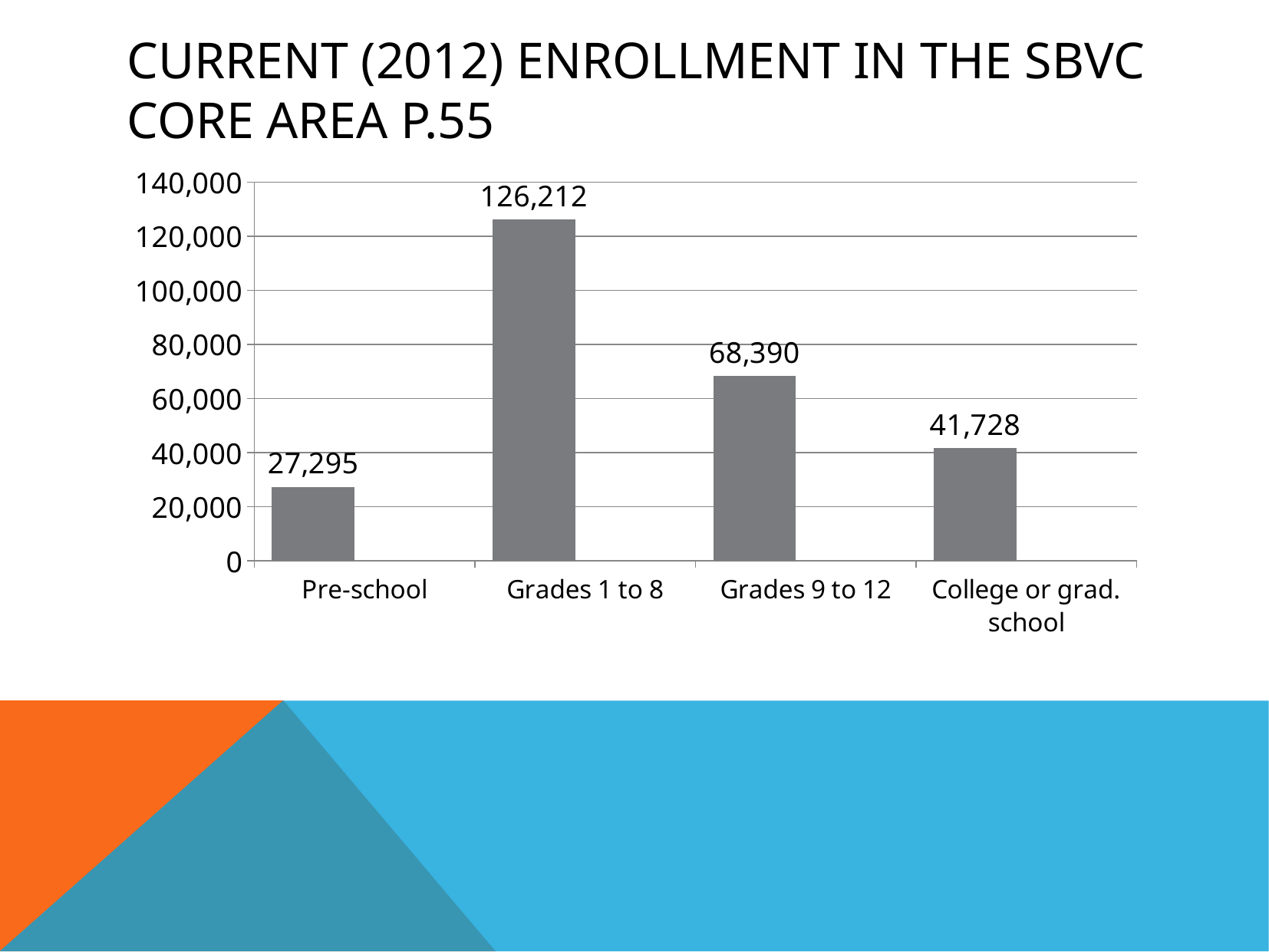
How many categories are shown in the chart? 4 What is the enrollment value for Grades 1 to 8? 126,212 What is the enrollment value for Grades 9 to 12? 68,390 What is the difference in enrollment between Grades 1 to 8 and Grades 9 to 12? 57,822 What kind of chart is shown on the slide? Bar chart What is the enrollment value for Pre-school? 27,295 What is the enrollment value for College or grad. school? 41,728 Which has a larger enrollment, Grades 9 to 12 or College or grad. school? Grades 9 to 12 What is the title of the slide? CURRENT (2012) ENROLLMENT IN THE SBVC CORE AREA P.55 What is the difference in enrollment between College or grad. school and Pre-school? 14,433 Which category has the lowest enrollment? Pre-school Which category has the highest enrollment? Grades 1 to 8